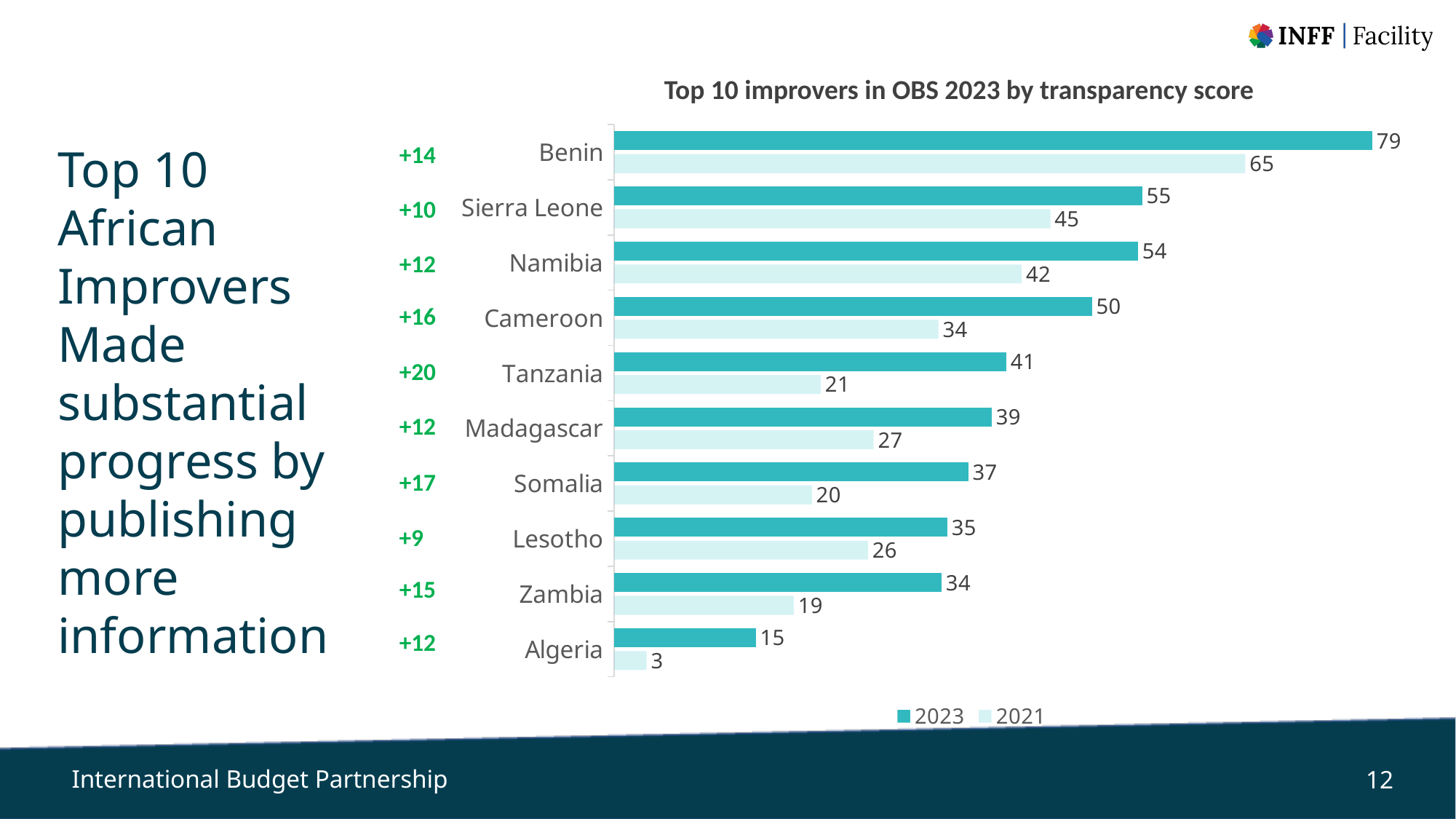
Which country has the highest 2023 transparency score? Benin What was Tanzania's transparency score in 2021? 21 Which country shows the largest improvement (+20) between 2021 and 2023? Tanzania Which country has the lowest 2021 transparency score? Algeria What type of chart is shown on the slide? Bar chart Which is larger: Sierra Leone's 2023 score or Namibia's 2023 score? Sierra Leone's 2023 score How many countries are shown in the chart? 10 How many series does the legend list? 2 What is the title of the chart? Top 10 improvers in OBS 2023 by transparency score What is the 2023 transparency score for Algeria? 15 What is the 2023 transparency score for Benin? 79 What is the difference between Cameroon's 2023 and 2021 transparency scores? 16